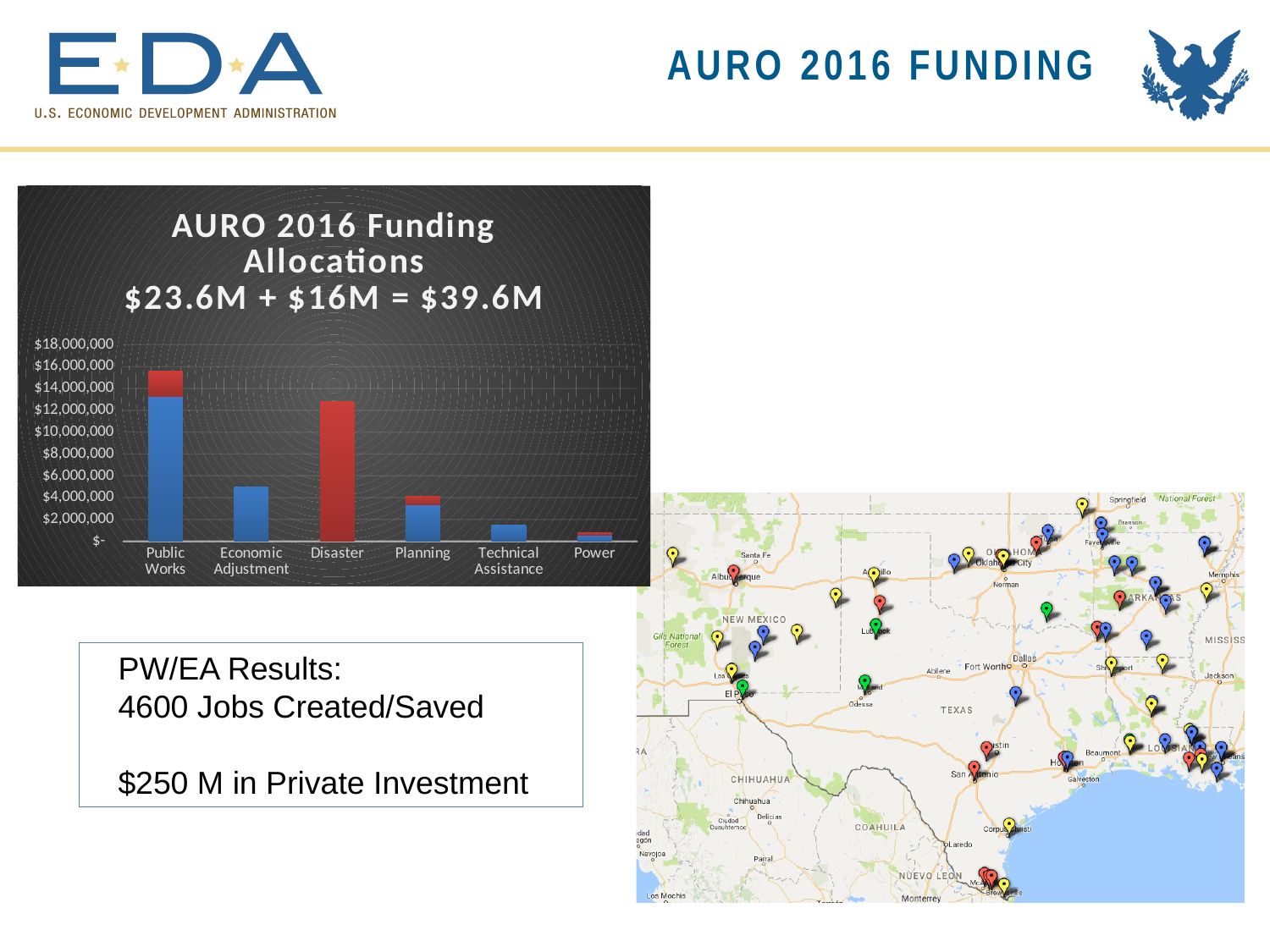
Which is larger, the bar for Economic Adjustment or the bar for Planning? Economic Adjustment What is the highest value labelled on the y axis of the chart? $18,000,000 Is the value for Technical Assistance greater or less than $2,000,000? less What total funding amount is stated in the chart title? $39.6M What kind of chart is shown on the slide? bar chart Which is larger, the bar for Public Works or the bar for Disaster? Public Works Is the total value for Public Works greater or less than $14,000,000? greater Which category has the lowest bar in the AURO 2016 Funding Allocations chart? Power Which category has the highest total bar in the AURO 2016 Funding Allocations chart? Public Works How many categories are shown on the x axis of the AURO 2016 Funding Allocations chart? 6 Is the value for Disaster greater or less than $14,000,000? less